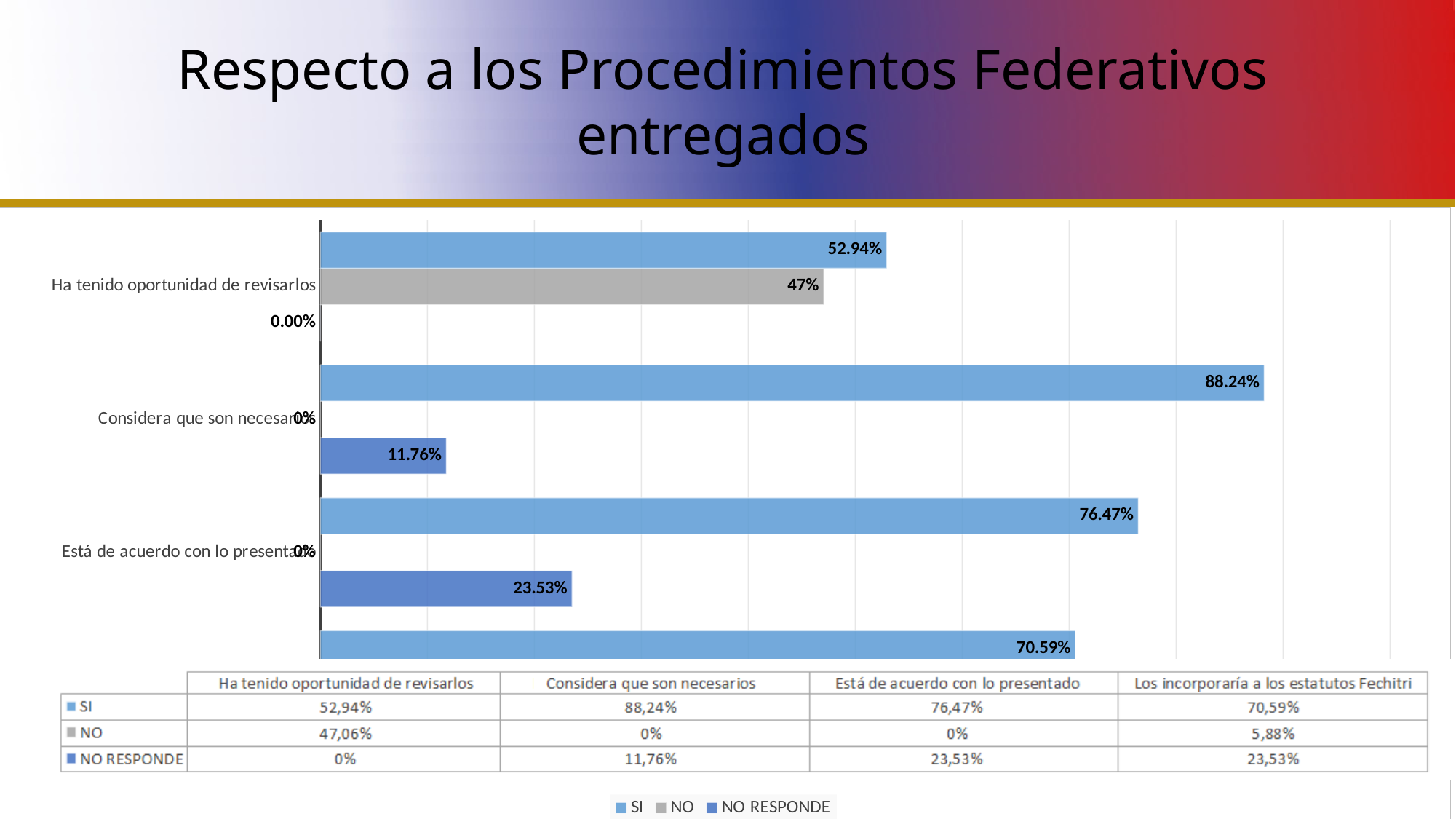
Which category has the lowest SI value? Ha tenido oportunidad de revisarlos Which is larger: the SI value for 'Ha tenido oportunidad de revisarlos' or the SI value for 'Los incorporaría a los estatutos Fechitri'? Los incorporaría a los estatutos Fechitri Which category has the highest SI value? Considera que son necesarios What is the NO value for 'Ha tenido oportunidad de revisarlos'? 47% What is the NO RESPONDE value for 'Considera que son necesarios'? 11.76% According to the data table, what is the NO value for 'Los incorporaría a los estatutos Fechitri'? 5,88% What is the difference between the SI values for 'Considera que son necesarios' and 'Está de acuerdo con lo presentado'? 11.77% What kind of chart is shown on the slide? bar chart What is the SI value for 'Ha tenido oportunidad de revisarlos'? 52.94% How many series does the legend list? 3 What is the SI value for 'Considera que son necesarios'? 88.24% What is the NO RESPONDE value for 'Está de acuerdo con lo presentado'? 23.53%